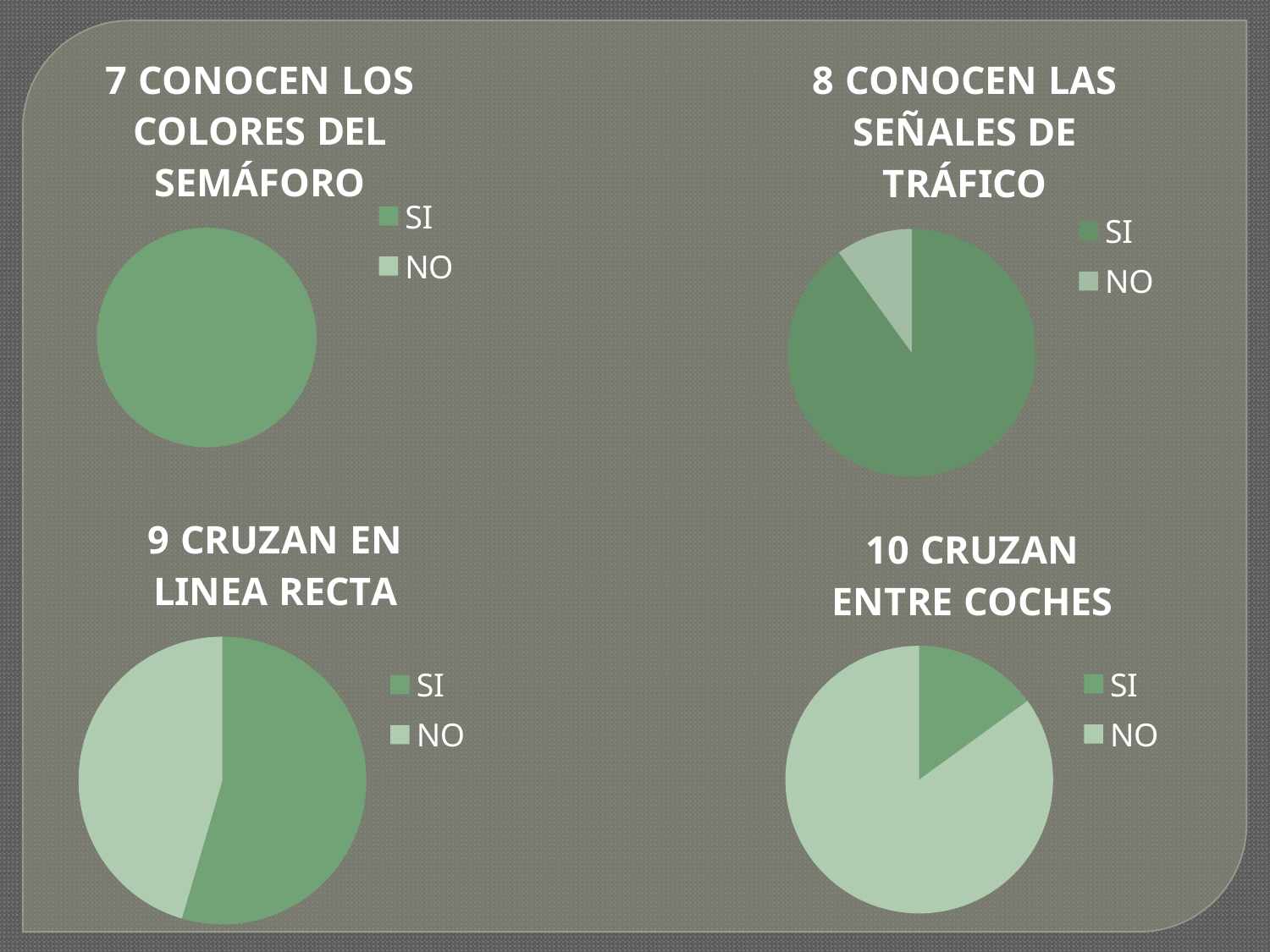
In the chart "8 CONOCEN LAS SEÑALES DE TRÁFICO", is the SI slice larger or smaller than the NO slice? Larger What are the two legend entries in the chart "7 CONOCEN LOS COLORES DEL SEMÁFORO"? SI and NO In the chart "8 CONOCEN LAS SEÑALES DE TRÁFICO", which slice is the largest? SI How many entries does the legend of the chart "9 CRUZAN EN LINEA RECTA" list? 2 In the chart "10 CRUZAN ENTRE COCHES", which slice is the smallest? SI What is the title of the chart in the bottom-left of the slide? 9 CRUZAN EN LINEA RECTA In the chart "10 CRUZAN ENTRE COCHES", which slice is the largest? NO In the chart "8 CONOCEN LAS SEÑALES DE TRÁFICO", which slice is the smallest? NO How many pie charts are shown on the slide? 4 In the chart "10 CRUZAN ENTRE COCHES", is the SI slice larger or smaller than the NO slice? Smaller In the chart "7 CONOCEN LOS COLORES DEL SEMÁFORO", which category fills the entire pie? SI What kind of chart is used for "7 CONOCEN LOS COLORES DEL SEMÁFORO"? Pie chart